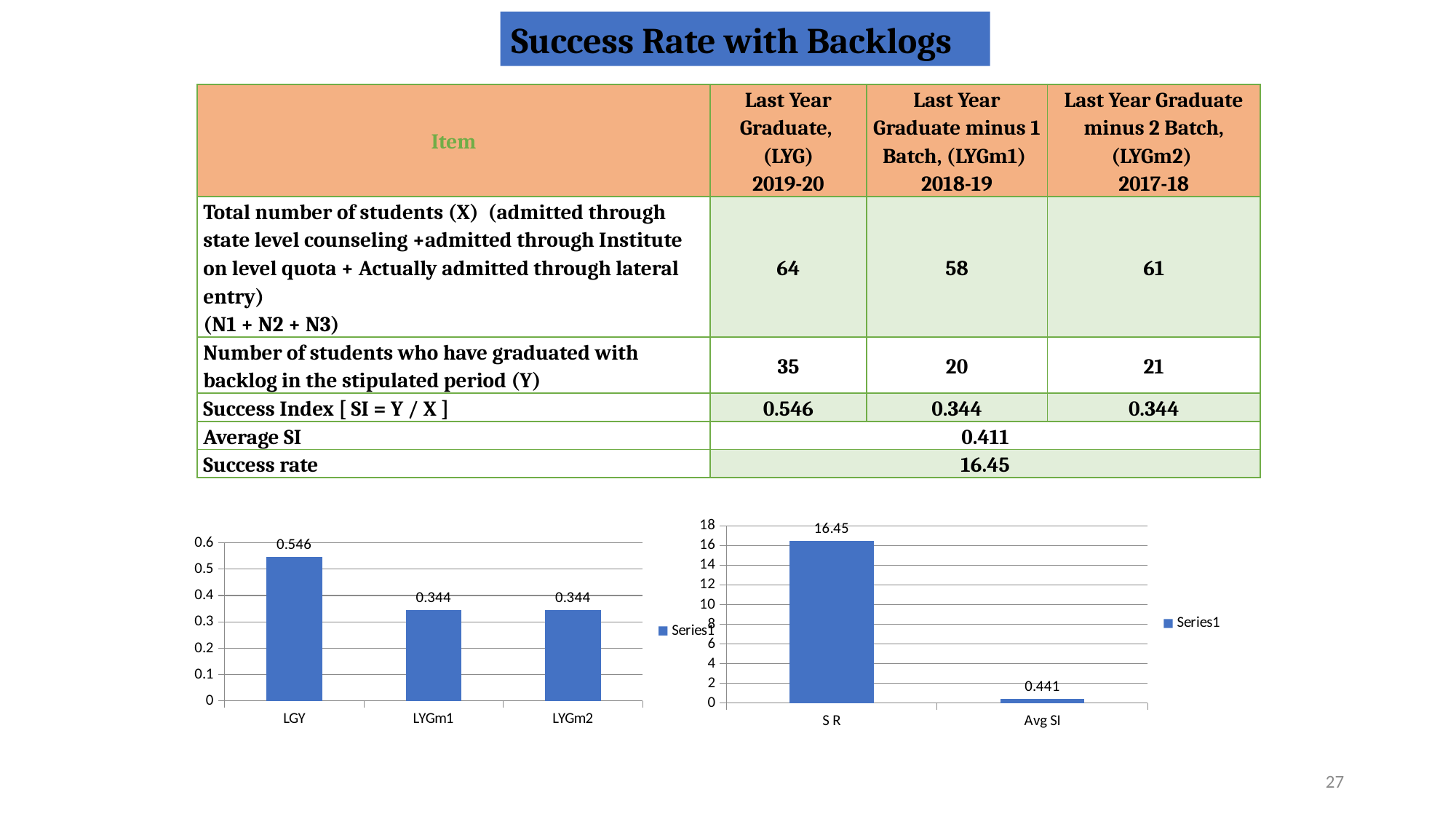
In the left chart, what is the difference between the values for LGY and LYGm2? 0.202 What kind of chart is the right chart? bar chart In the left chart, how many categories are shown on the x axis? 3 In the left chart, what is the value for LGY? 0.546 How many series does the legend of the left chart list? 1 In the left chart, is the value for LGY greater or less than 0.5? greater In the left chart, what is the value for LYGm1? 0.344 In the left chart, which category has the highest value? LGY In the right chart, what is the value labelled for Avg SI? 0.441 In the right chart, which is larger, S R or Avg SI? S R In the right chart, what is the value for S R? 16.45 In the right chart, which category has the lowest value? Avg SI